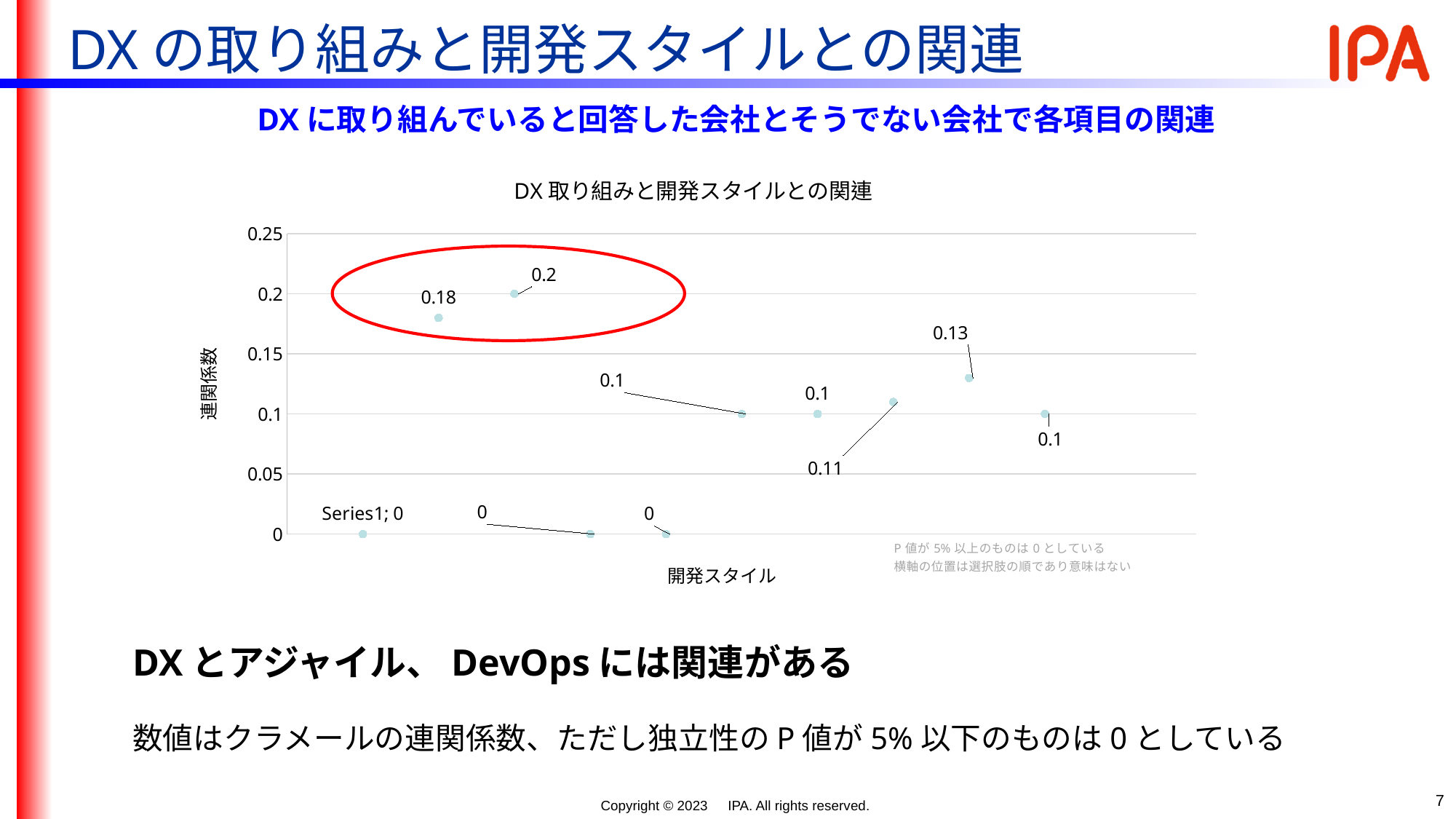
What is the lowest value plotted in the chart? 0 How many data points in the chart are labelled 0.1? 3 What kind of chart is shown on the slide? scatter chart What is the difference between the points labelled 0.13 and 0.11? 0.02 What is the highest value plotted in the chart? 0.2 What is the difference between the two values inside the red ellipse (0.2 and 0.18)? 0.02 Is the highest plotted value in the chart greater or less than 0.15? greater How many data points in the chart have a value of 0? 3 What is the label of the vertical axis of the chart? 連関係数 How many data points are plotted in the chart? 10 Which is larger, the point labelled 0.18 or the point labelled 0.13? 0.18 What is the title of the chart? DX取り組みと開発スタイルとの関連